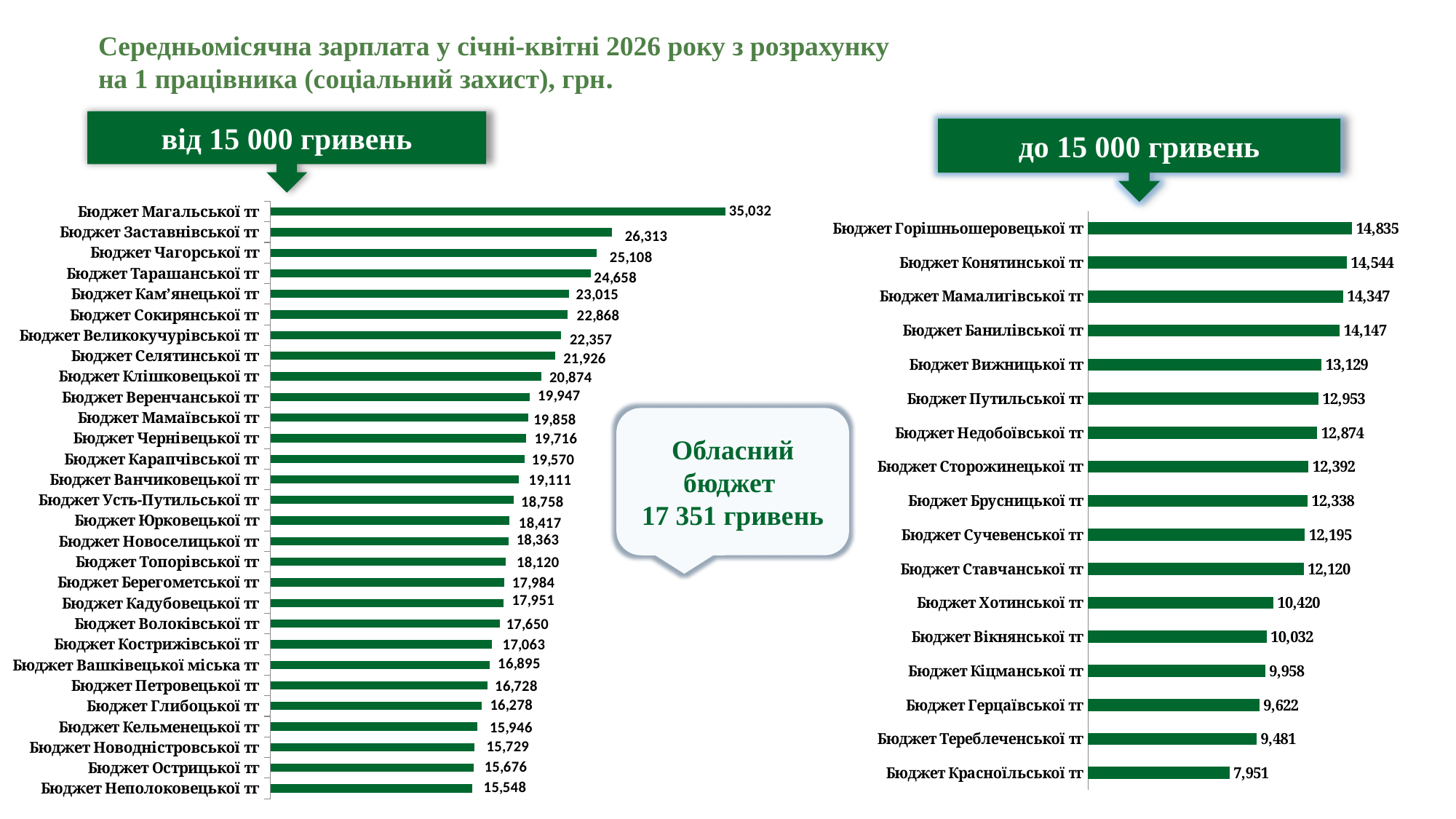
In the chart under 'до 15 000 гривень', what is the difference between Бюджет Хотинської тг and Бюджет Красноїльської тг? 2,469 In the chart under 'від 15 000 гривень', what is the value for Бюджет Магальської тг? 35,032 In the chart under 'до 15 000 гривень', what is the value for Бюджет Вижницької тг? 13,129 In the chart under 'від 15 000 гривень', which is larger: Бюджет Чагорської тг or Бюджет Тарашанської тг? Бюджет Чагорської тг What type of chart is used under 'до 15 000 гривень'? Bar chart In the chart under 'до 15 000 гривень', which is larger: Бюджет Кіцманської тг or Бюджет Вікнянської тг? Бюджет Вікнянської тг In the chart under 'до 15 000 гривень', which category has the lowest value? Бюджет Красноїльської тг In the chart under 'від 15 000 гривень', what is the difference between Бюджет Магальської тг and Бюджет Заставнівської тг? 8,719 In the chart under 'до 15 000 гривень', which category has the highest value? Бюджет Горішньошеровецької тг How many categories are shown in the chart under 'до 15 000 гривень'? 17 In the chart under 'від 15 000 гривень', which category has the lowest value? Бюджет Неполоковецької тг How many categories are shown in the chart under 'від 15 000 гривень'? 29